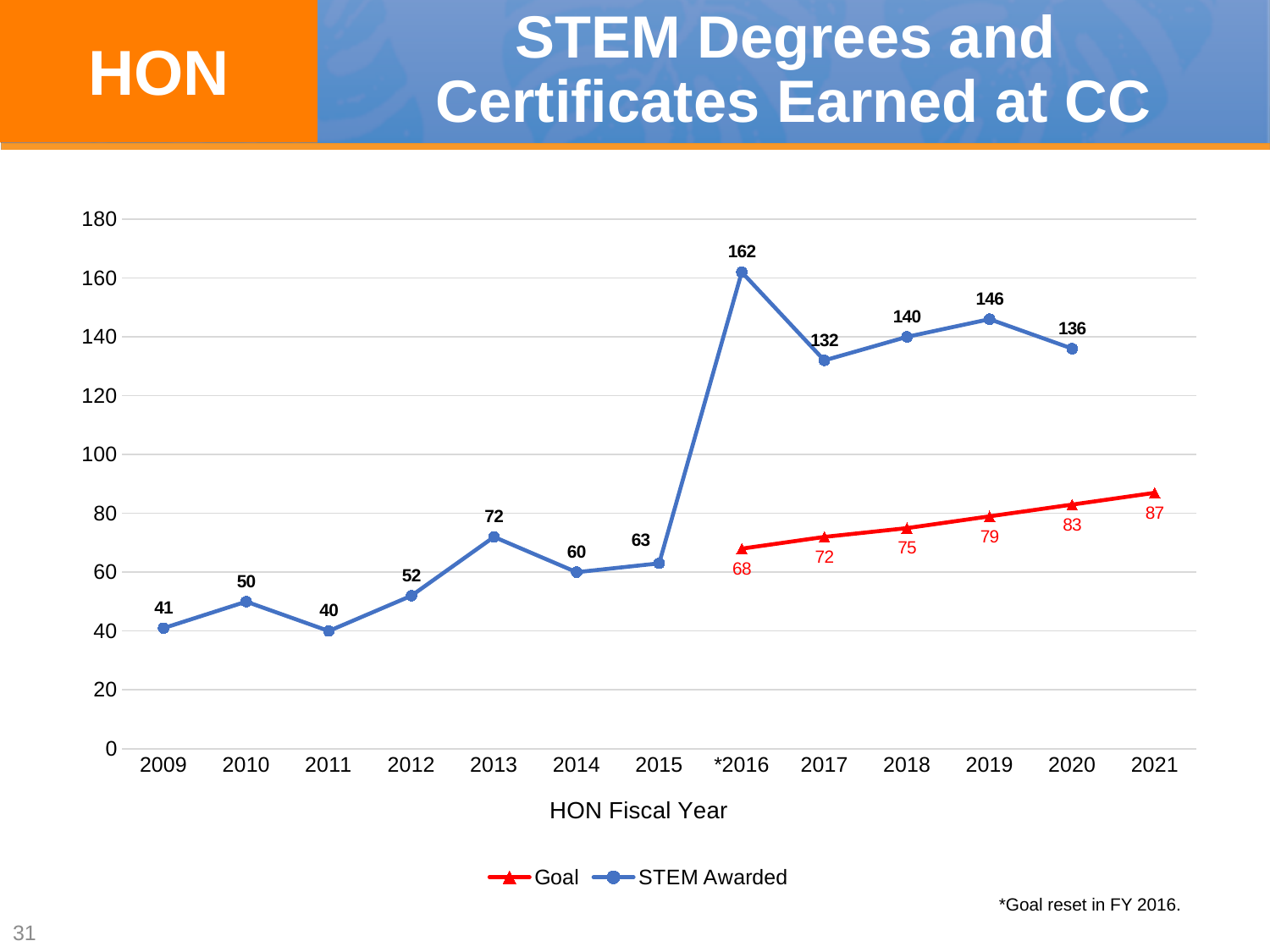
Does the Goal series rise or fall from 2016 to 2021? rise What kind of chart is shown on the slide? line chart How many series does the legend list? 2 How many years are shown on the x axis? 13 Which year has the lowest STEM Awarded value? 2011 What is the Goal value for 2019? 79 Is the STEM Awarded value for 2013 greater or less than 60? greater Which year has the highest STEM Awarded value? *2016 What is the difference between the STEM Awarded value and the Goal value in 2020? 53 What is the STEM Awarded value for 2016? 162 Which is larger in 2017: the STEM Awarded value or the Goal value? STEM Awarded What is the label of the x axis? HON Fiscal Year